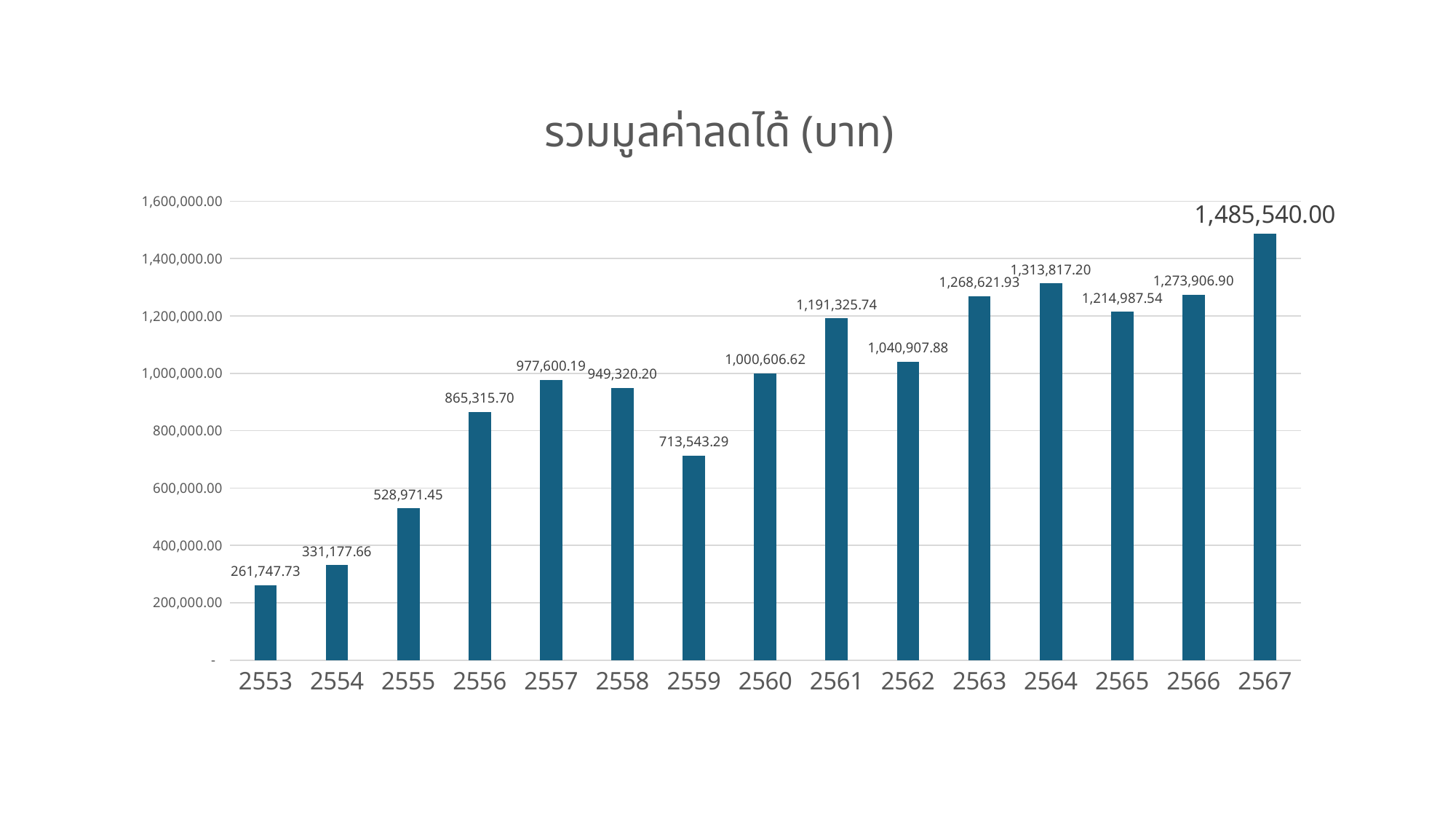
What type of chart is shown on the slide? Bar chart Is the value for 2562 greater or less than 1,000,000.00? greater How many years (bars) are shown in the chart? 15 What is the title of the chart? รวมมูลค่าลดได้ (บาท) Do the values generally rise or fall from 2553 to 2567? Rise What is the difference between the values for 2567 and 2566? 211,633.10 What is the value for 2553? 261,747.73 What is the value for 2559? 713,543.29 Which year has the highest value? 2567 Which is larger, the value for 2558 or the value for 2559? 2558 What is the value for 2564? 1,313,817.20 Which year has the lowest value? 2553